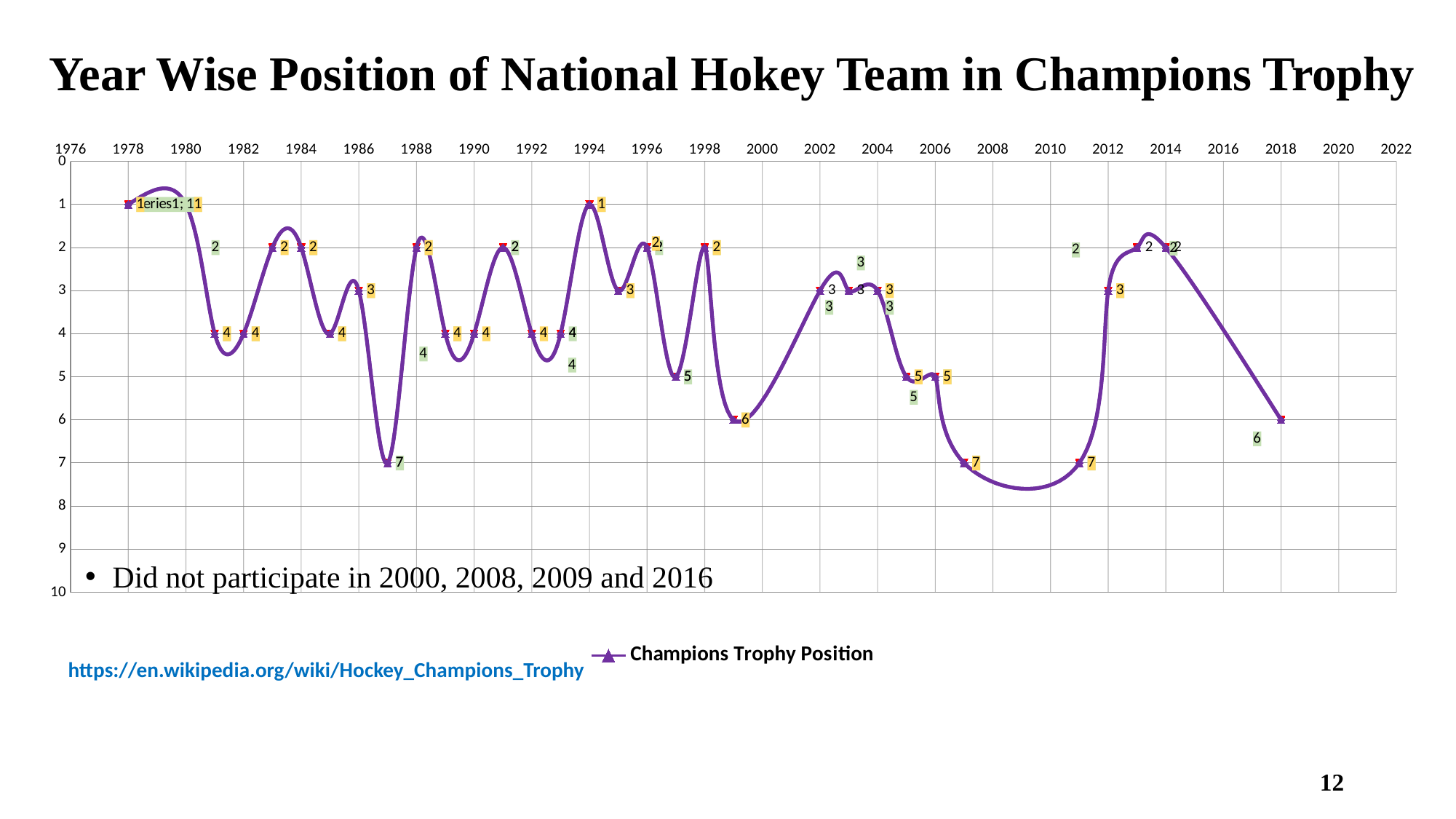
What position did the team achieve in 1994? 1 Does the position number rise or fall from 2014 to 2018? rise What position did the team achieve in 1999? 6 Which year has the larger position number, 2011 or 2012? 2011 What kind of chart is shown on the slide? line chart How many series does the legend list? 1 What position did the team achieve in 2018? 6 What is the highest position number (worst finish) plotted on the chart? 7 What is the name of the series shown in the legend? Champions Trophy Position What is the difference between the position in 1987 and the position in 1994? 6 What position did the team achieve in 2012? 3 What position did the team achieve in 1987? 7